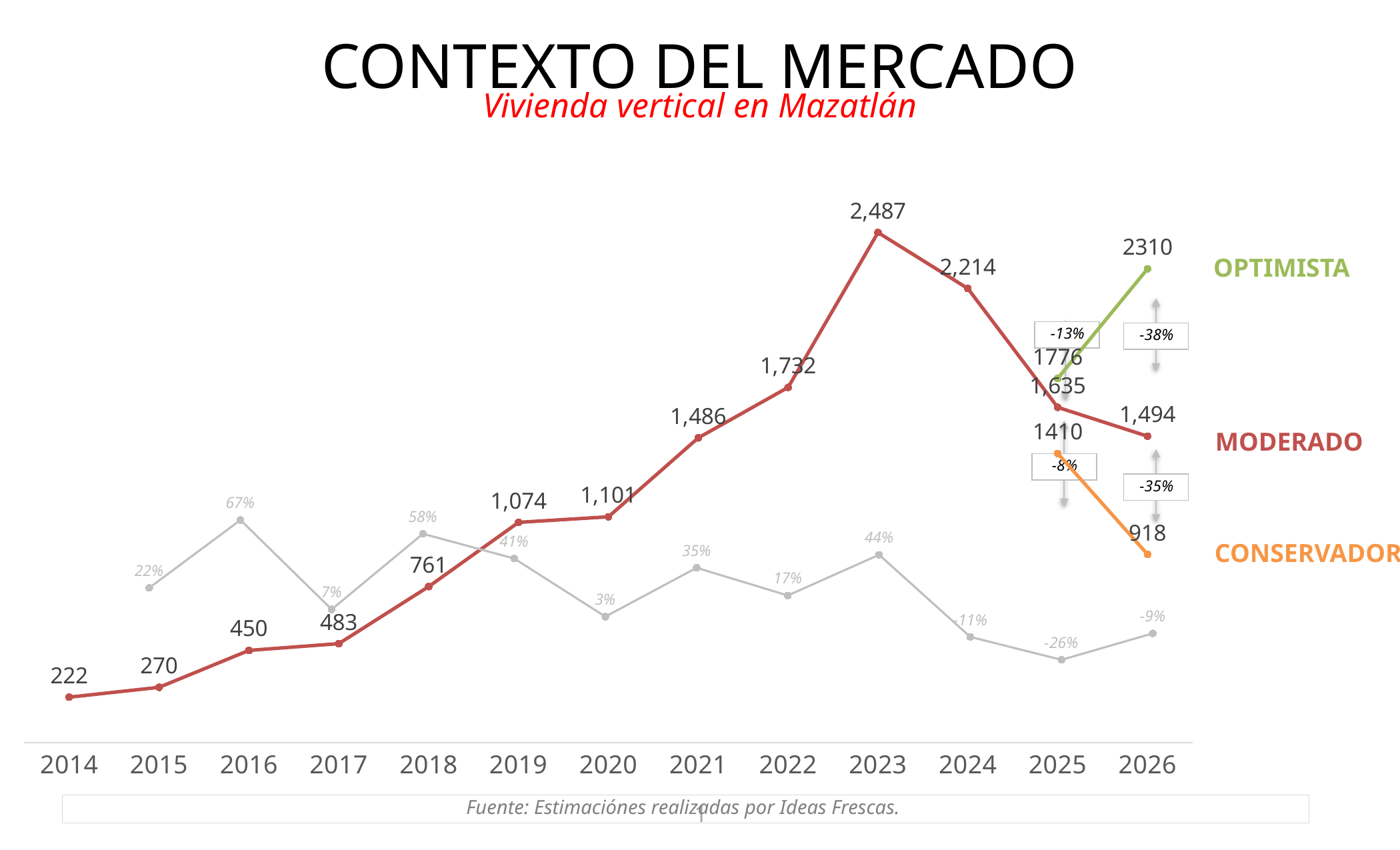
What is the CONSERVADOR value for 2026? 918 Which is larger, the MODERADO value for 2019 or for 2020? 2020 Does the MODERADO line rise or fall between 2014 and 2023? rise How many years are shown on the x axis? 13 In which year does the MODERADO line have its lowest value? 2014 What type of chart is shown on the slide? line chart What is the difference between the MODERADO values for 2023 and 2024? 273 What is the value of the MODERADO line in 2023? 2,487 What is the value of the MODERADO line in 2014? 222 What is the OPTIMISTA value for 2026? 2310 In which year does the MODERADO line reach its highest value? 2023 What percentage growth is shown on the grey line for 2016? 67%